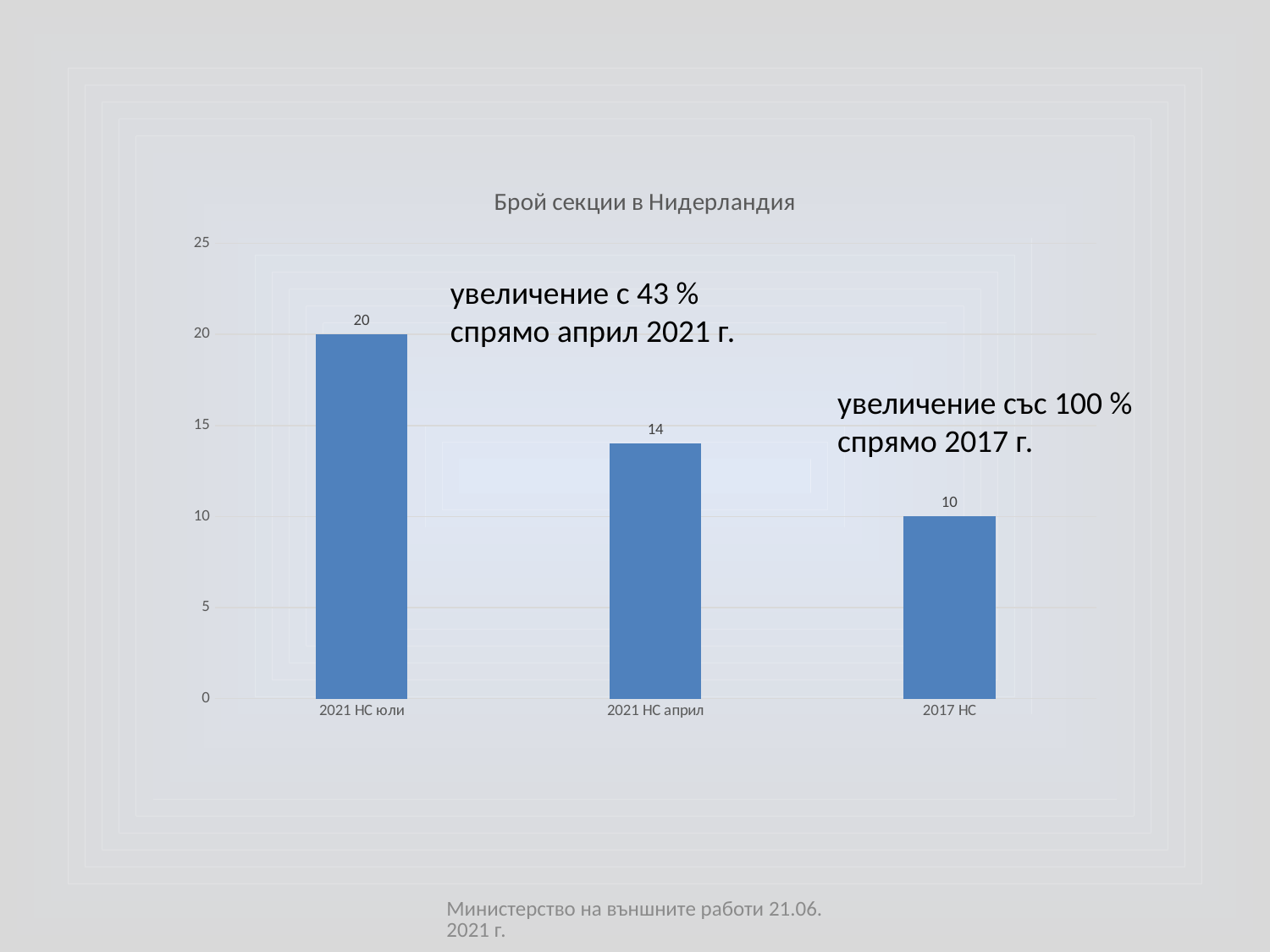
Is the value for 2021 НС април greater or less than 15? less What is the difference between the values for 2021 НС юли and 2017 НС? 10 What is the difference between the values for 2021 НС юли and 2021 НС април? 6 What kind of chart is shown on the slide? bar chart Which is larger, the value for 2021 НС април or the value for 2017 НС? 2021 НС април Which category has the highest value? 2021 НС юли How many categories are shown on the x axis? 3 What is the value for 2017 НС? 10 Which category has the lowest value? 2017 НС What is the value for 2021 НС юли? 20 What is the title of the chart? Брой секции в Нидерландия What is the value for 2021 НС април? 14